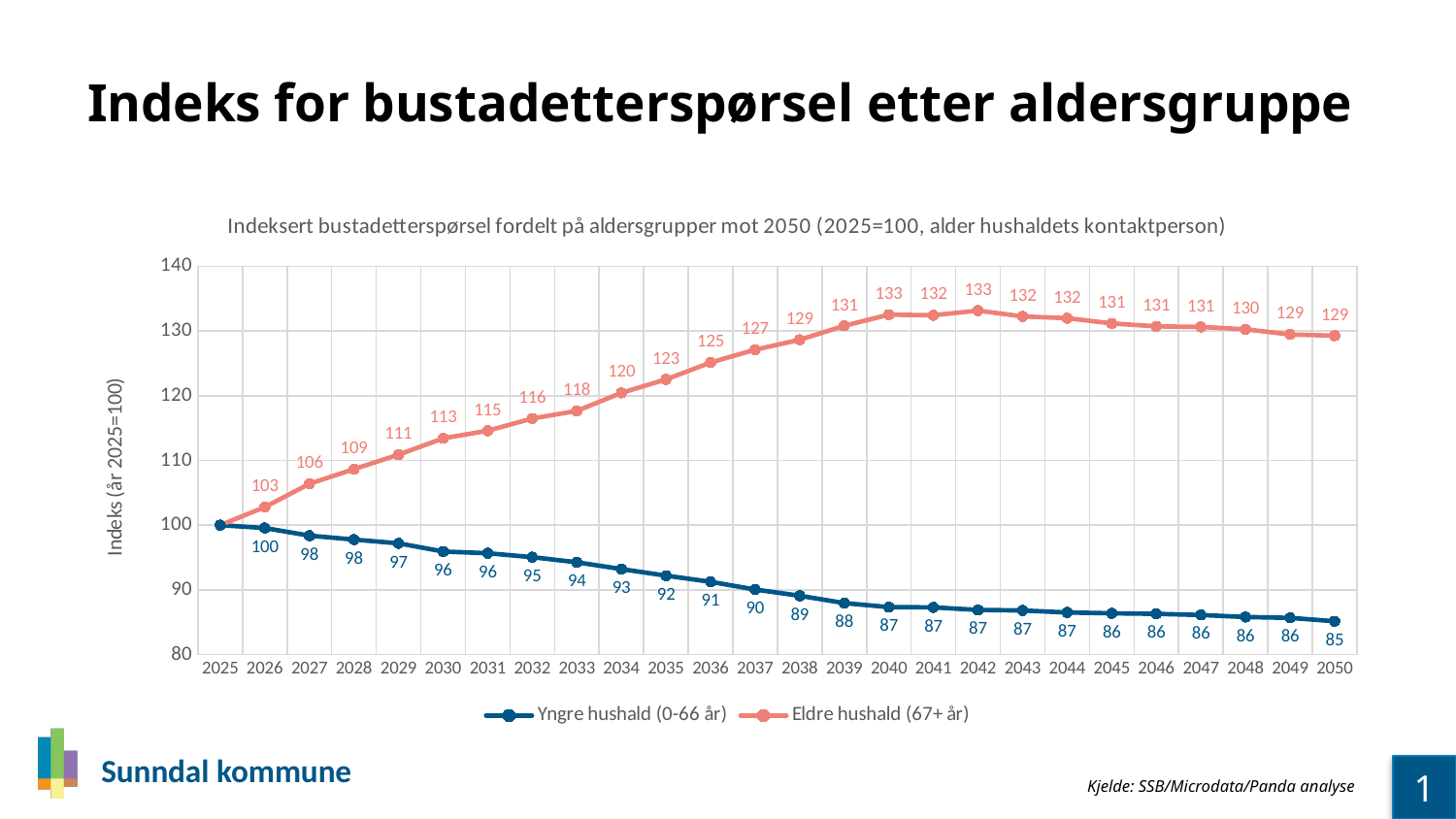
How many series does the legend list? 2 Is the value for Eldre hushald (67+ år) in 2030 greater or less than 110? greater What is the value for Eldre hushald (67+ år) in 2050? 129 What is the value for Eldre hushald (67+ år) in 2040? 133 What is the value for Yngre hushald (0-66 år) in 2037? 90 What is the difference between Eldre hushald (67+ år) and Yngre hushald (0-66 år) in 2050? 44 In which year does Yngre hushald (0-66 år) reach its lowest value? 2050 Does the value for Yngre hushald (0-66 år) rise or fall from 2025 to 2050? Fall What is the value for Yngre hushald (0-66 år) in 2050? 85 What kind of chart is shown on the slide? Line chart How many years are shown on the x axis? 26 Which series has the higher value in 2035, Yngre hushald (0-66 år) or Eldre hushald (67+ år)? Eldre hushald (67+ år)